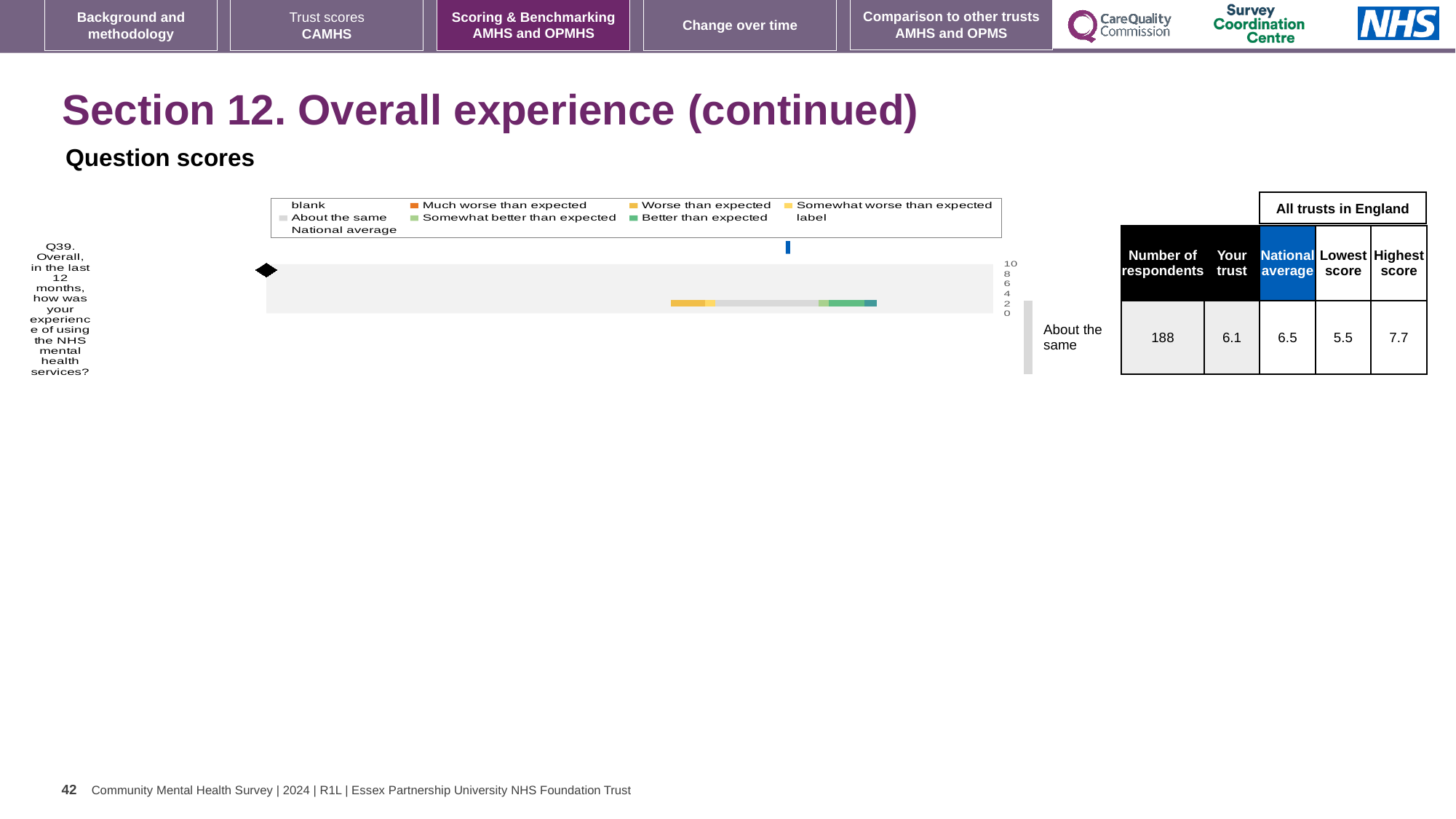
What is the 'Your trust' score for Q39? 6.1 What is the highest score among all trusts in England for Q39? 7.7 Which question is plotted in the chart? Q39. Overall, in the last 12 months, how was your experience of using the NHS mental health services? Which is larger for Q39, the 'Your trust' score or the national average? National average How many questions (categories) are plotted in the chart? 1 What is the number of respondents for Q39? 188 What kind of chart is shown on the slide? bar chart How many entries does the chart legend list? 9 What is the difference between the highest score and the lowest score for Q39? 2.2 What is the benchmark category shown for Q39? About the same What is the lowest score among all trusts in England for Q39? 5.5 What is the national average score for Q39? 6.5